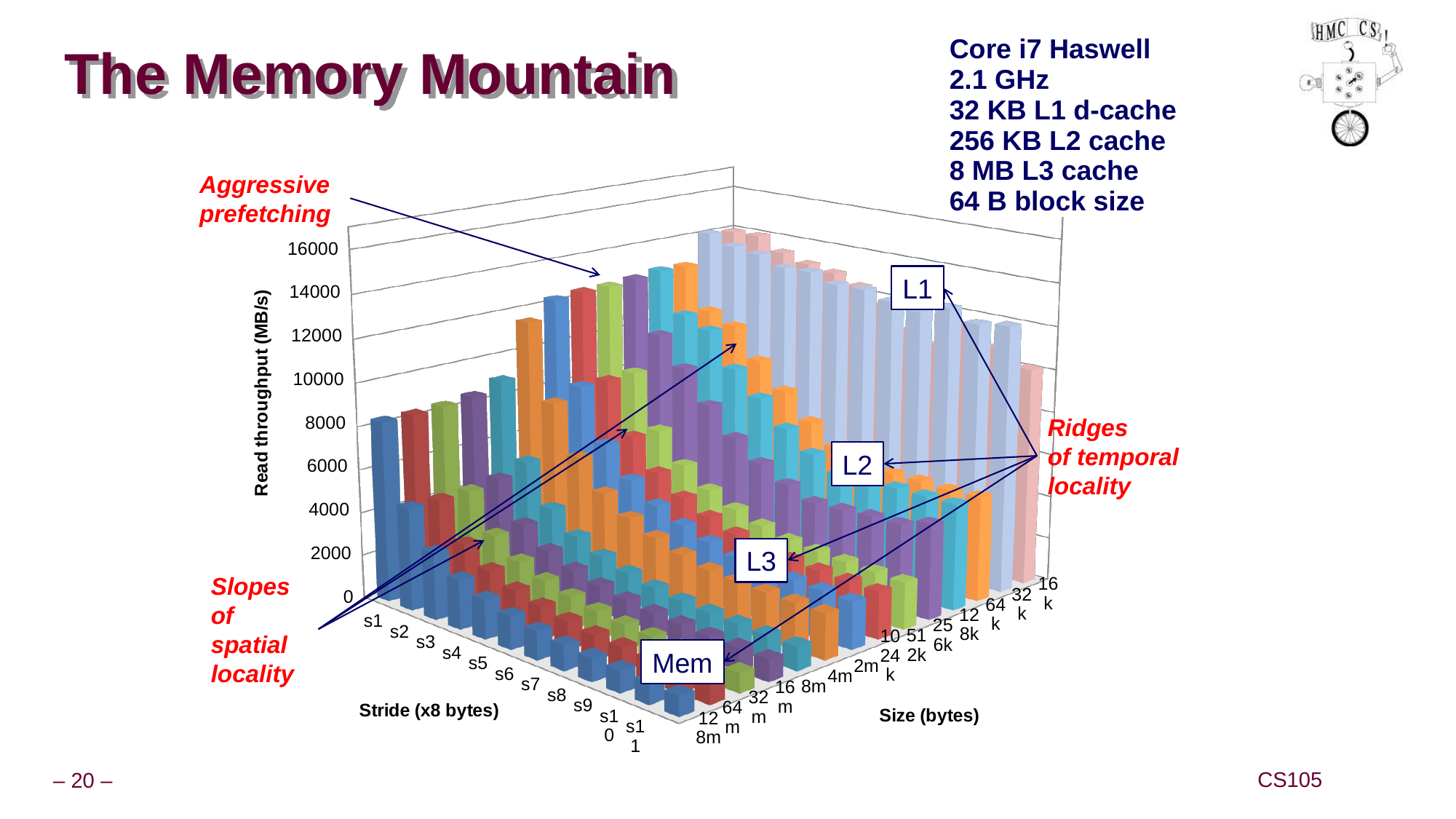
How many stride categories are shown along the stride axis? 11 What kind of chart is shown on the slide? bar chart For the 128m size, is the read throughput at stride s11 greater or less than 2000? less For the 128m size, which stride has the highest read throughput? s1 For the 128m size, is the read throughput at stride s1 greater or less than 6000? greater What is the title of the vertical axis of the chart? Read throughput (MB/s) How many size categories are shown along the size axis? 14 What is the highest tick value shown on the read throughput axis? 16000 For the 4m size, is the read throughput at stride s1 greater or less than 10000? greater For stride s1, which has the higher read throughput, size 128m or size 4m? 4m For the 128m size, does read throughput rise or fall as the stride increases from s1 to s11? fall For the 128m size, which has the higher read throughput, stride s1 or stride s11? s1